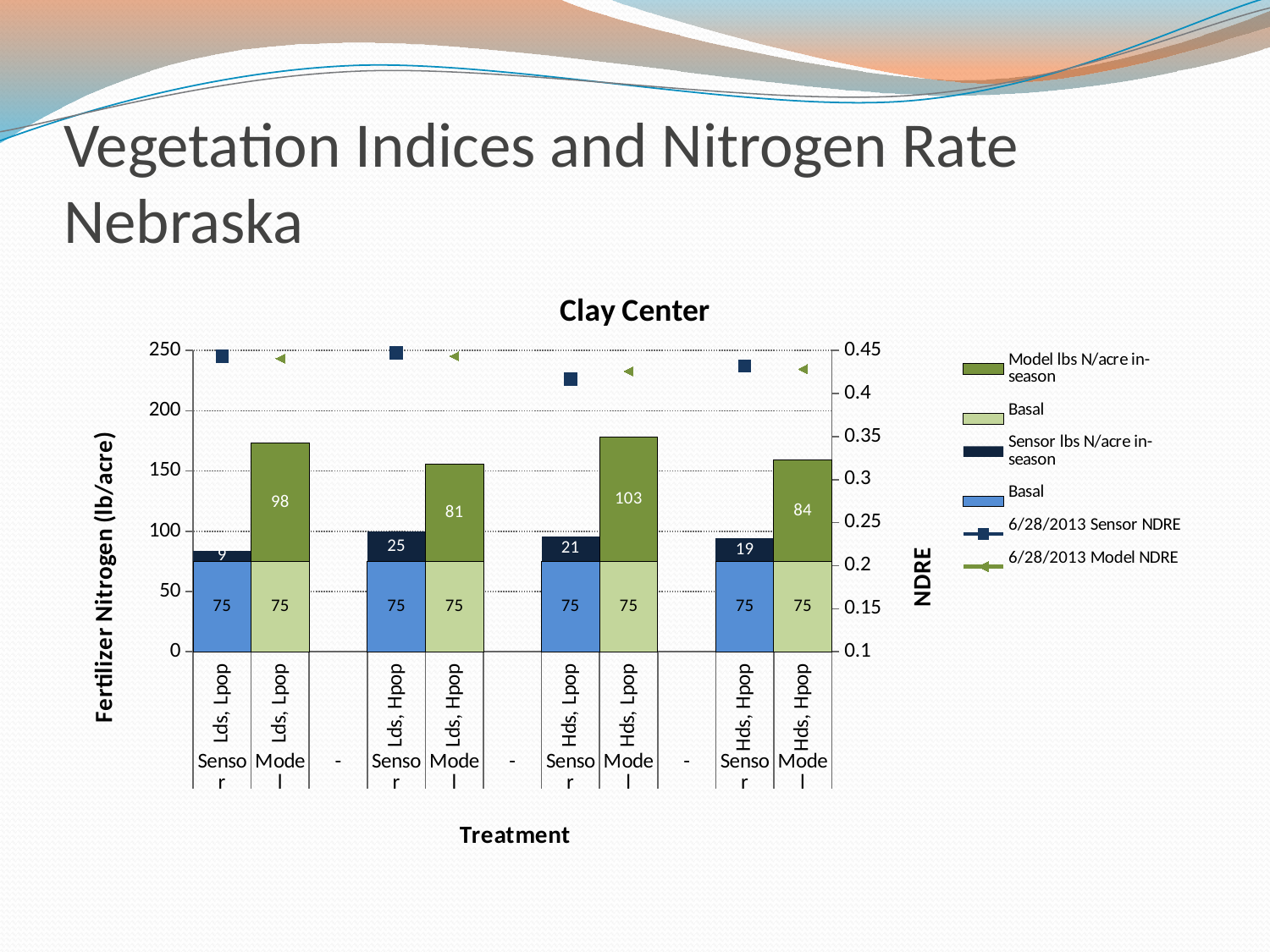
What is the label of the right-hand vertical axis? NDRE Which treatment has the highest Model lbs N/acre in-season value? Hds, Lpop What is the total height of the Model stacked bar for the Lds, Lpop treatment? 173 What is the difference between the Model in-season value for Hds, Lpop and the Model in-season value for Lds, Hpop? 22 What is the Sensor lbs N/acre in-season value for the Lds, Hpop treatment? 25 What is the title of the chart? Clay Center What is the total height of the Sensor stacked bar for the Lds, Hpop treatment? 100 Which treatment has the lowest Sensor lbs N/acre in-season value? Lds, Lpop What is the Model lbs N/acre in-season value for the Hds, Lpop treatment? 103 How many entries does the legend list? 6 Which is larger: the Sensor in-season value for Hds, Lpop or for Hds, Hpop? Hds, Lpop What is the Basal value shown for the Lds, Lpop Sensor bar? 75